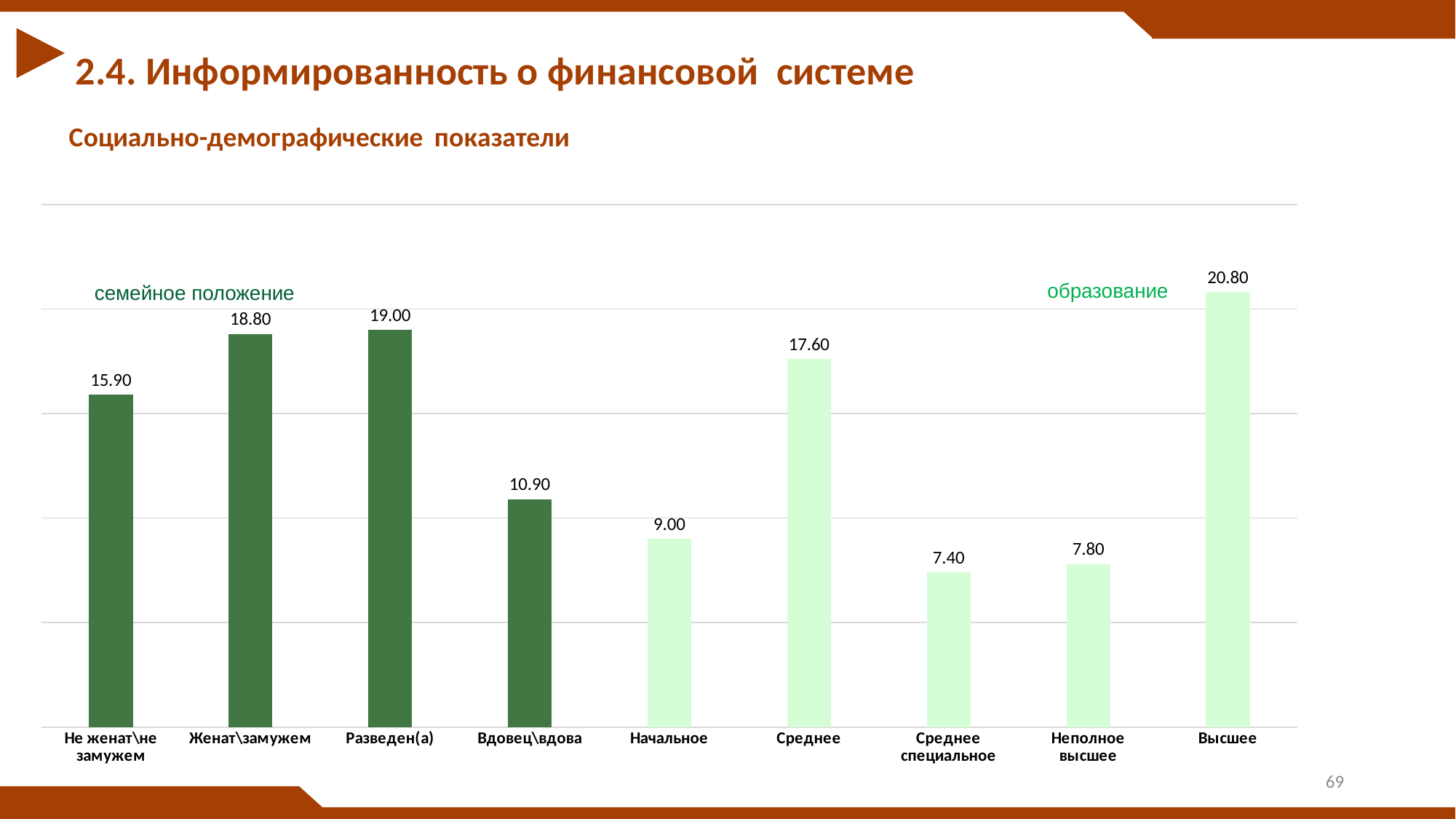
Which category has the lowest value on the chart? Среднее специальное How many categories are shown on the chart? 9 Which category has the highest value on the chart? Высшее What is the value for Вдовец\вдова? 10.90 What is the difference between the values for Женат\замужем and Не женат\не замужем? 2.90 Which is larger, the value for Среднее or the value for Неполное высшее? Среднее What is the value for Среднее специальное? 7.40 What kind of chart is shown on the slide? Bar chart What is the difference between the values for Высшее and Начальное? 11.80 Which is larger, the value for Не женат\не замужем or the value for Начальное? Не женат\не замужем What is the value for Разведен(а)? 19.00 What are the two group labels shown above the bars on the chart? семейное положение and образование